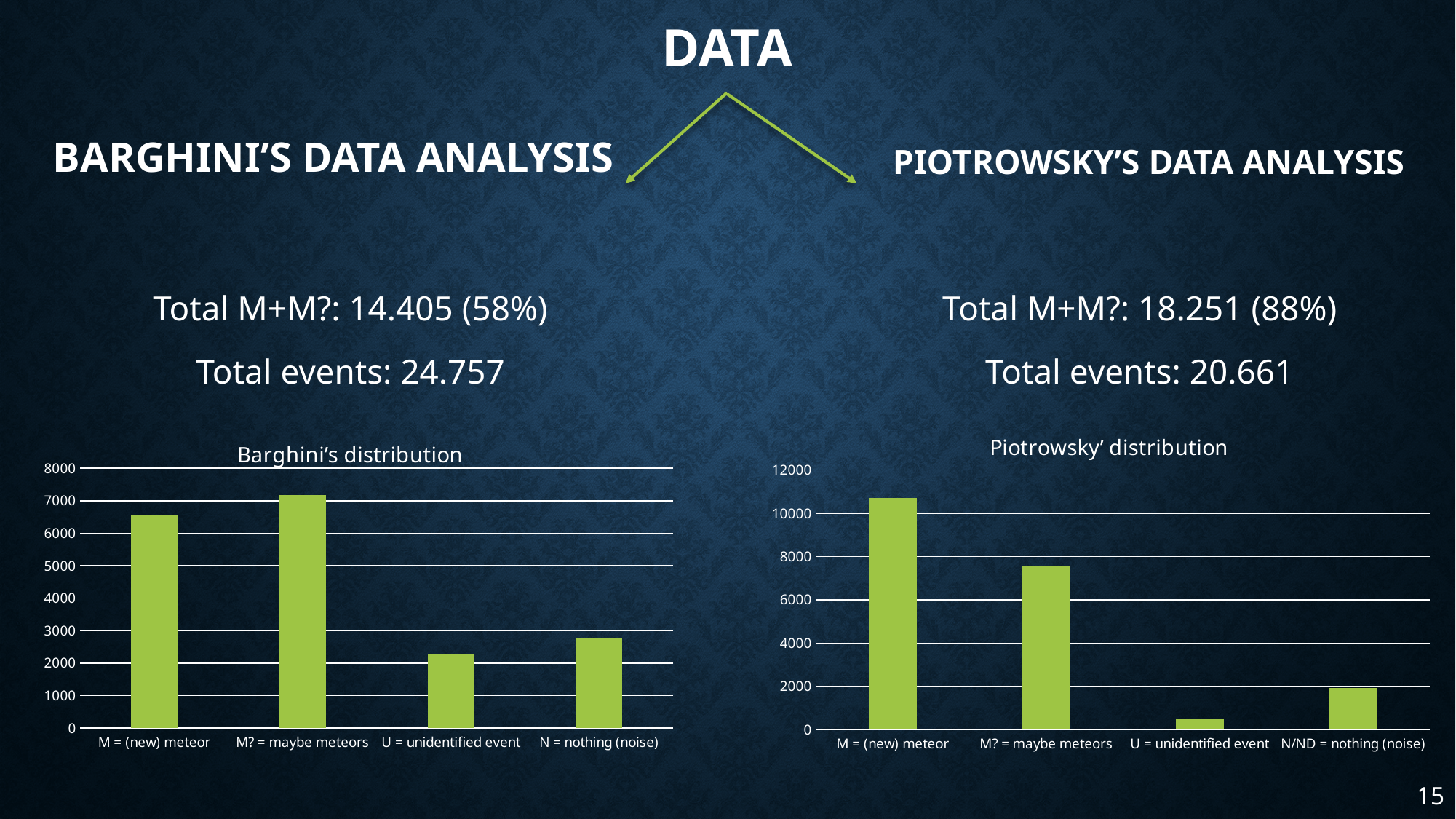
What kind of chart is the Barghini's distribution chart? bar chart In the Barghini's distribution chart, is the value for N = nothing (noise) greater or less than 3000? less In the Piotrowsky' distribution chart, which is larger, the value for M? = maybe meteors or the value for U = unidentified event? M? = maybe meteors In the Barghini's distribution chart, which category has the lowest value? U = unidentified event What is the highest value shown on the vertical axis of the Piotrowsky' distribution chart? 12000 In the Piotrowsky' distribution chart, which category has the highest value? M = (new) meteor In the Piotrowsky' distribution chart, is the value for M = (new) meteor greater or less than 10000? greater In the Barghini's distribution chart, how many categories are shown? 4 In the Piotrowsky' distribution chart, which category has the lowest value? U = unidentified event In the Barghini's distribution chart, is the value for M = (new) meteor greater or less than 6000? greater In the Barghini's distribution chart, which category has the highest value? M? = maybe meteors